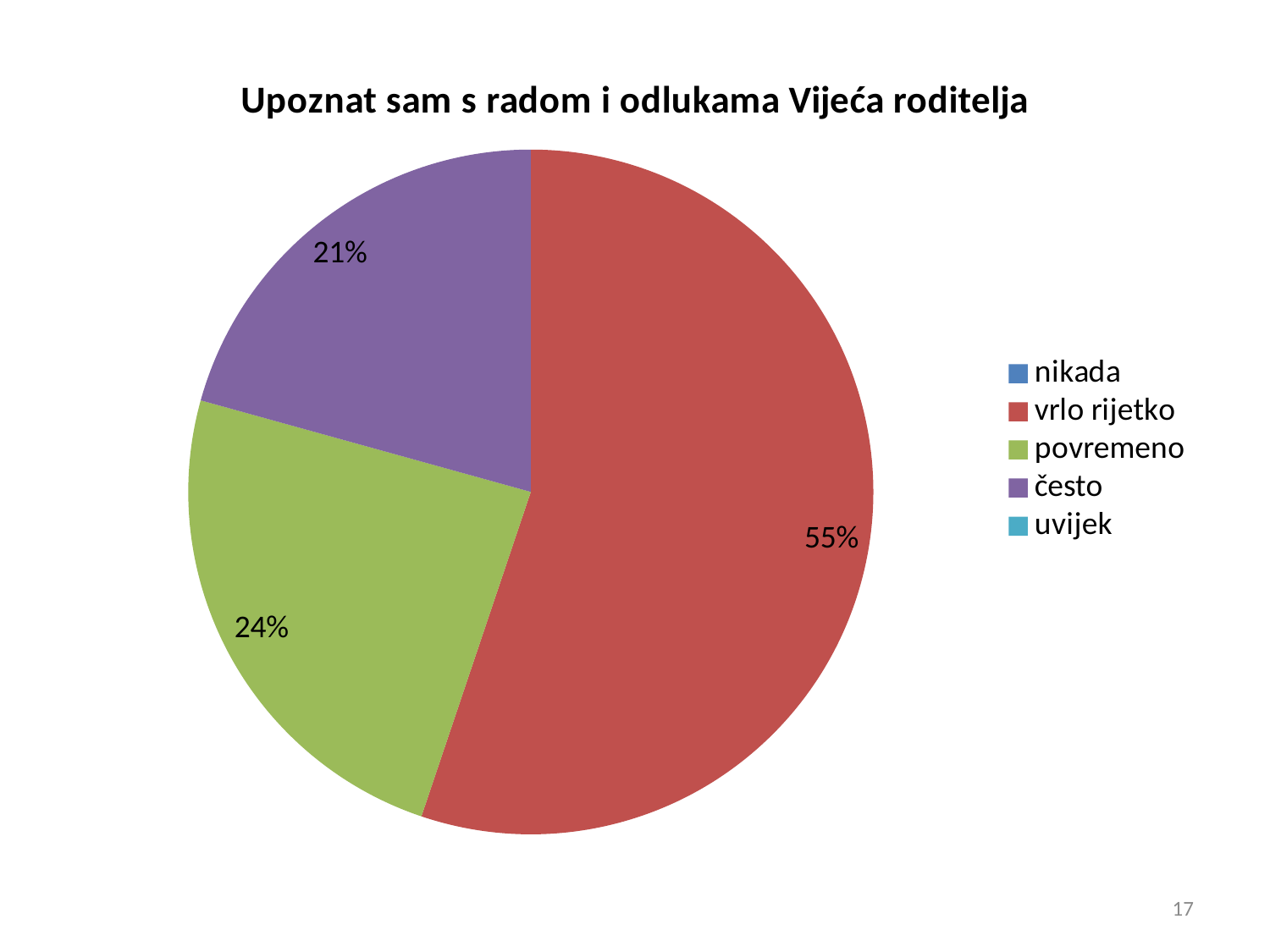
What is the difference in percentage points between "povremeno" and "često"? 3 What is the difference in percentage points between "vrlo rijetko" and "povremeno"? 31 What share of the pie does "povremeno" have? 24% How many entries does the legend list? 5 What share of the pie does "vrlo rijetko" have? 55% What share of the pie does "često" have? 21% Which category has the largest slice of the pie? vrlo rijetko How many slices with printed percentage labels are visible in the pie? 3 Which is larger, the share for "povremeno" or the share for "često"? povremeno Of the slices with printed labels, which category has the smallest share? često What kind of chart is shown on the slide? pie chart What is the title of the chart? Upoznat sam s radom i odlukama Vijeća roditelja